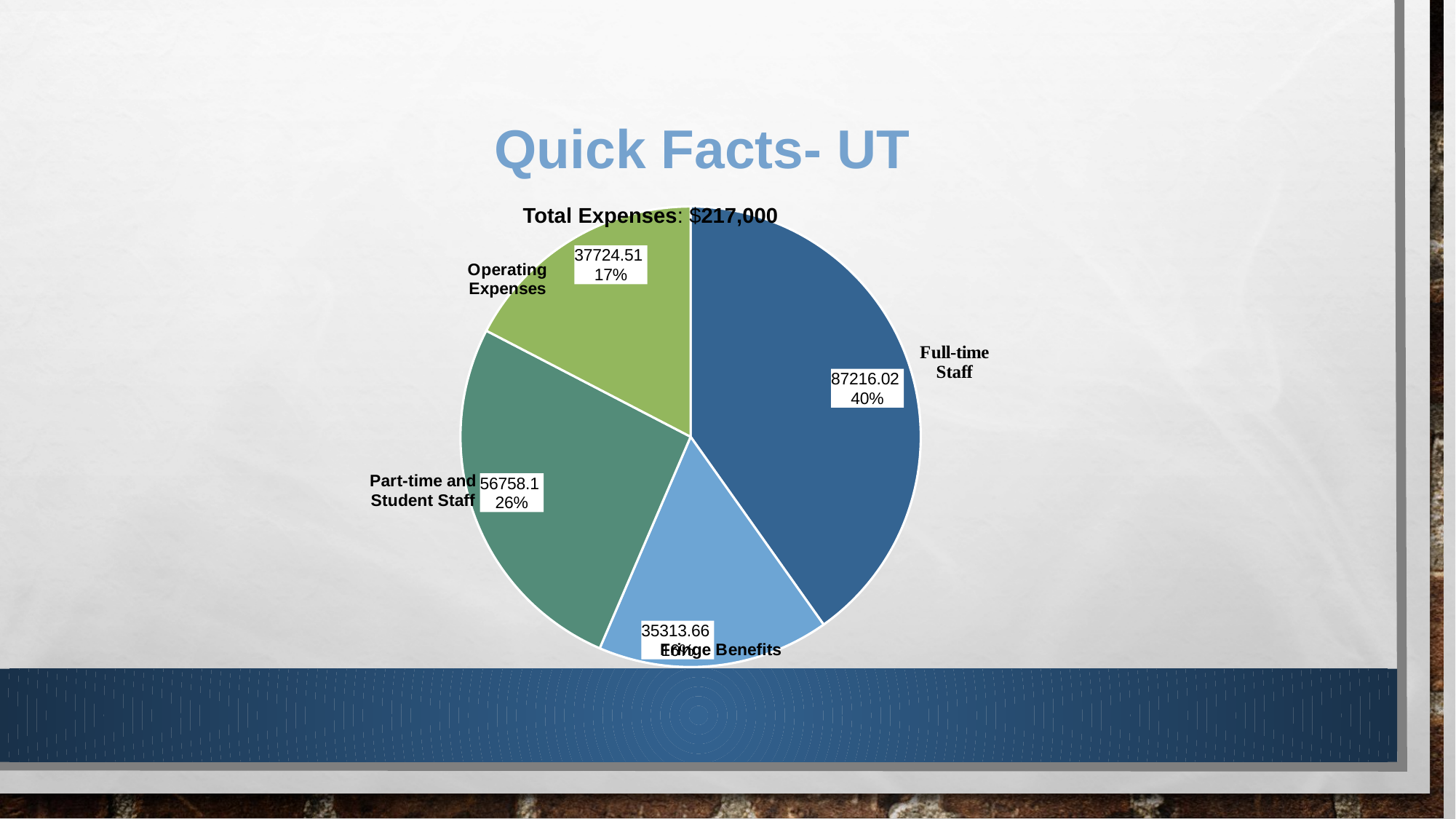
What is the value shown for Full-time Staff? 87216.02 What percentage of the pie does Part-time and Student Staff represent? 26% Which is larger, Part-time and Student Staff or Operating Expenses? Part-time and Student Staff What total expenses amount is stated in the chart title? $217,000 How many slices does the pie chart have? 4 Which category has the largest slice of the pie? Full-time Staff What is the value shown for Fringe Benefits? 35313.66 What is the value shown for Operating Expenses? 37724.51 What percentage of the pie does Full-time Staff represent? 40% What kind of chart is shown on the slide? pie chart What percentage of the pie does Operating Expenses represent? 17% What is the value shown for Part-time and Student Staff? 56758.1